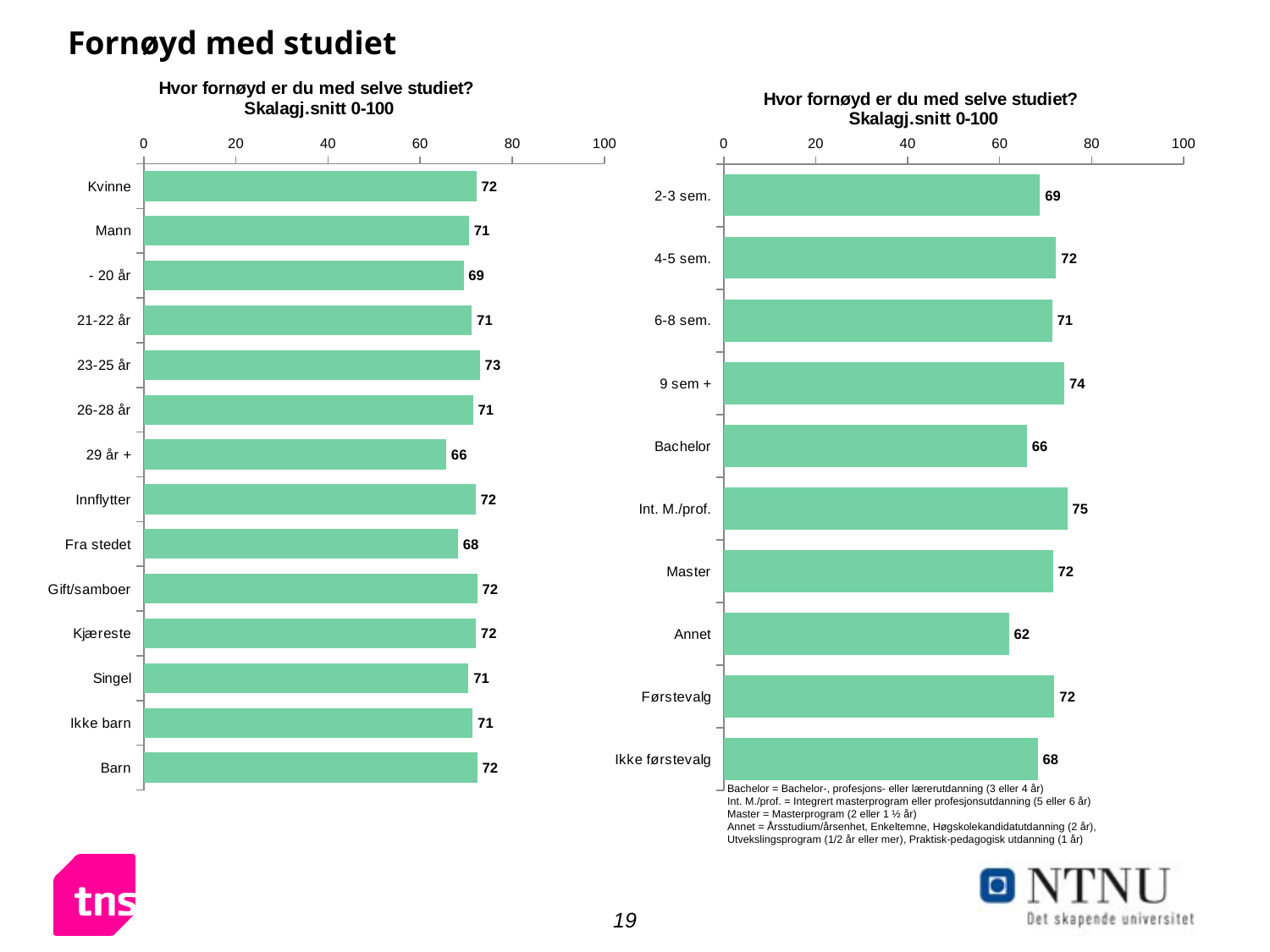
In the right chart, what is the difference between the values for Førstevalg and Ikke førstevalg? 4 In the left chart, which category has the highest value? 23-25 år In the right chart, which is larger, the value for 9 sem + or the value for 2-3 sem.? 9 sem + In the left chart, what is the value for Kvinne? 72 In the left chart, what is the value for 29 år +? 66 What kind of chart is the right chart? Bar chart In the right chart, which category has the highest value? Int. M./prof. In the left chart, which category has the lowest value? 29 år + In the left chart, what is the difference between the values for Innflytter and Fra stedet? 4 In the left chart, how many categories are shown? 14 In the right chart, which category has the lowest value? Annet In the right chart, what is the value for Annet? 62